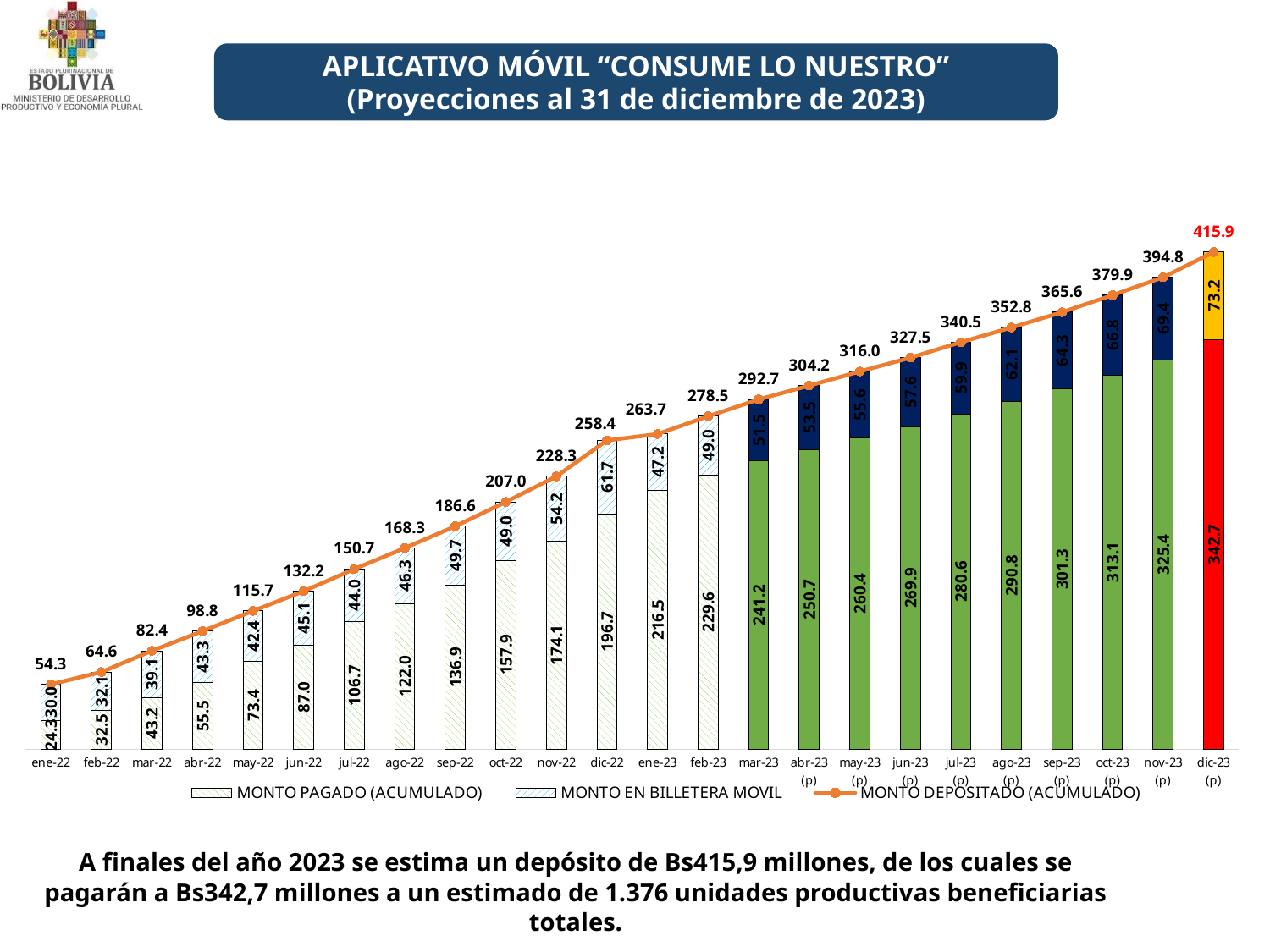
Which month has the highest MONTO EN BILLETERA MOVIL value? dic-23 (p) Does the MONTO DEPOSITADO (ACUMULADO) line rise or fall from ene-22 to dic-23 (p)? Rise What kind of chart is shown on the slide? Stacked bar chart with a line What is the MONTO DEPOSITADO (ACUMULADO) value for dic-23 (p)? 415.9 What is the difference between the MONTO DEPOSITADO (ACUMULADO) values for dic-23 (p) and nov-23 (p)? 21.1 What is the MONTO EN BILLETERA MOVIL value for jun-23 (p)? 57.6 Which month has the lowest MONTO DEPOSITADO (ACUMULADO) value? ene-22 How many months are shown on the x axis? 24 Which is larger: the MONTO EN BILLETERA MOVIL value for dic-22 or for ene-23? dic-22 How many series does the legend list? 3 What is the MONTO PAGADO (ACUMULADO) value for dic-22? 196.7